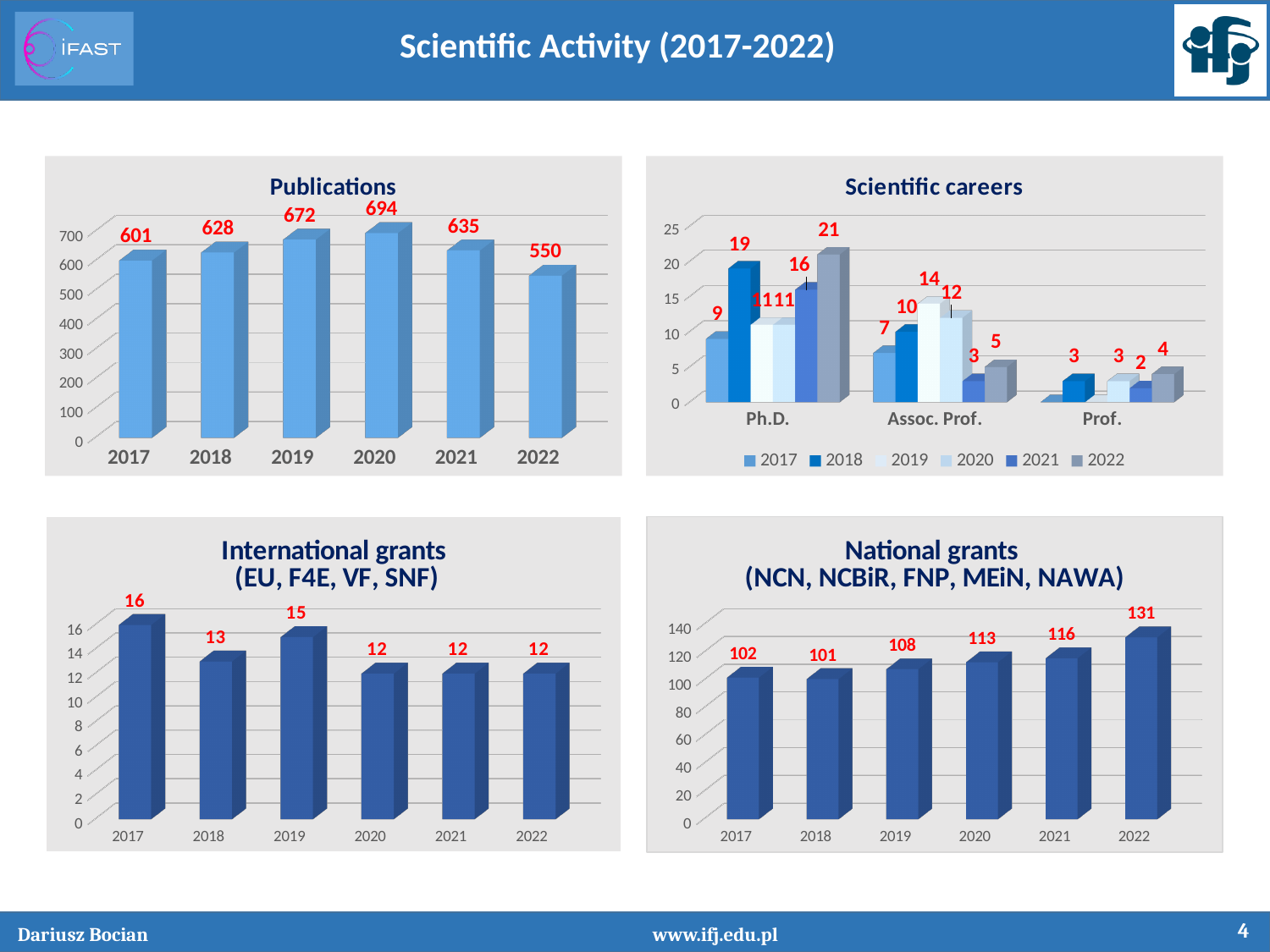
In the Publications chart, which year has the lowest value? 2022 In the International grants chart, what is the value for 2019? 15 In the Publications chart, how many publications were there in 2020? 694 In the Scientific careers chart, how many series does the legend list? 6 In the National grants chart, what is the difference between the 2022 and 2017 values? 29 In the Scientific careers chart, what is the Assoc. Prof. value for 2019? 14 In the International grants chart, which year has the highest value? 2017 In the National grants chart, what is the value for 2022? 131 In the Publications chart, what is the difference between the 2019 and 2022 values? 122 What kind of chart is the National grants chart? bar chart In the Scientific careers chart, what is the Ph.D. value for 2022? 21 In the Scientific careers chart, which is larger for Ph.D.: the 2018 value or the 2017 value? 2018